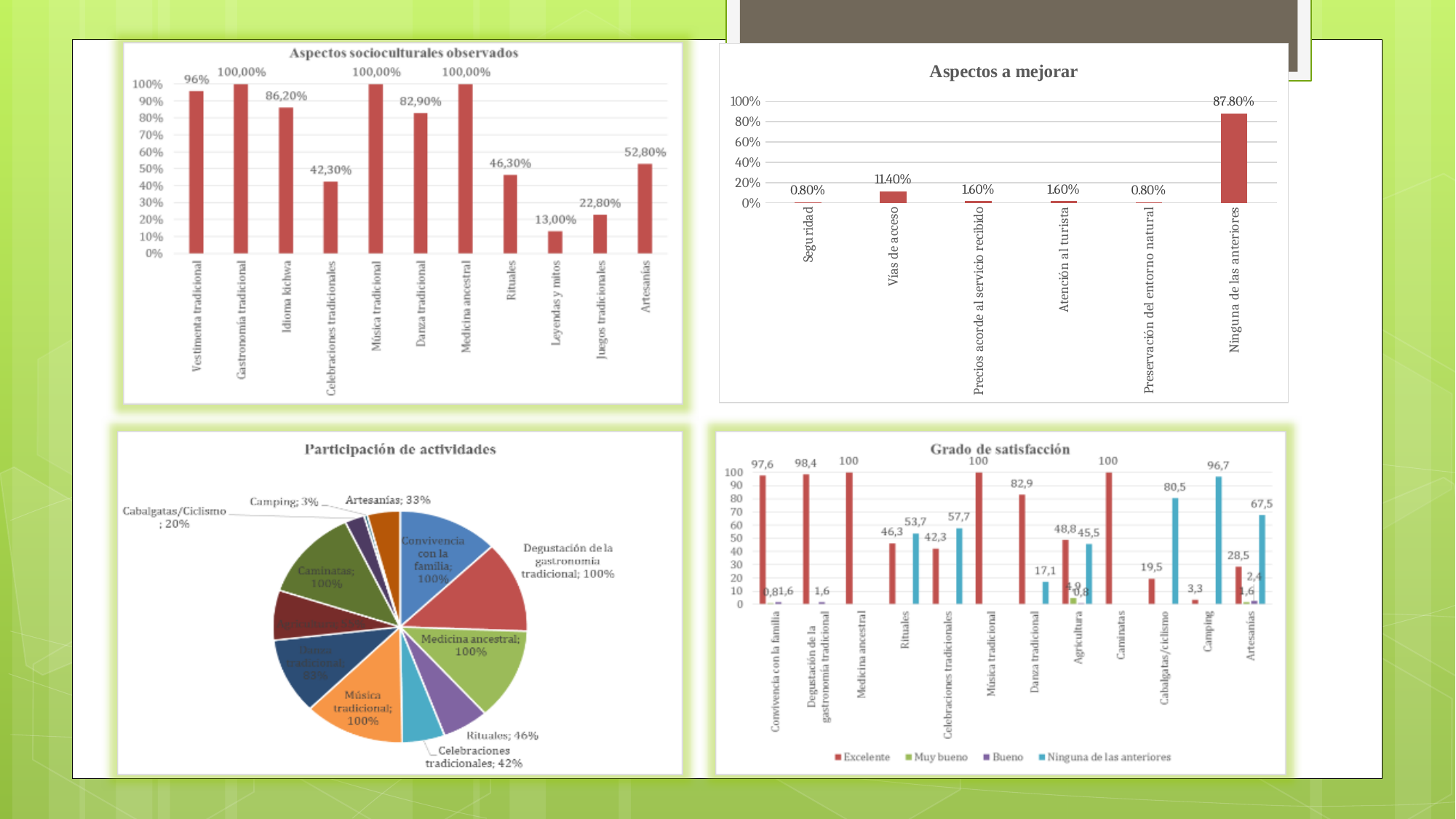
How many series does the legend of the 'Grado de satisfacción' chart list? 4 In the 'Aspectos socioculturales observados' chart, which category has the lowest value? Leyendas y mitos In the 'Participación de actividades' pie chart, which is larger, Rituales or Artesanías? Rituales In the 'Aspectos a mejorar' chart, which category has the highest value? Ninguna de las anteriores In the 'Aspectos a mejorar' chart, what is the value for Vías de acceso? 11.40% In the 'Aspectos socioculturales observados' chart, what is the value for Idioma kichwa? 86,20% In the 'Grado de satisfacción' chart, what is the 'Ninguna de las anteriores' value for Camping? 96,7 In the 'Participación de actividades' pie chart, what share is shown for Cabalgatas/Ciclismo? 20% In the 'Aspectos a mejorar' chart, what is the difference between Ninguna de las anteriores and Vías de acceso? 76.40% What kind of chart is 'Participación de actividades'? Pie chart In the 'Grado de satisfacción' chart, what is the Excelente value for Danza tradicional? 82,9 In the 'Aspectos socioculturales observados' chart, how many categories are shown? 11